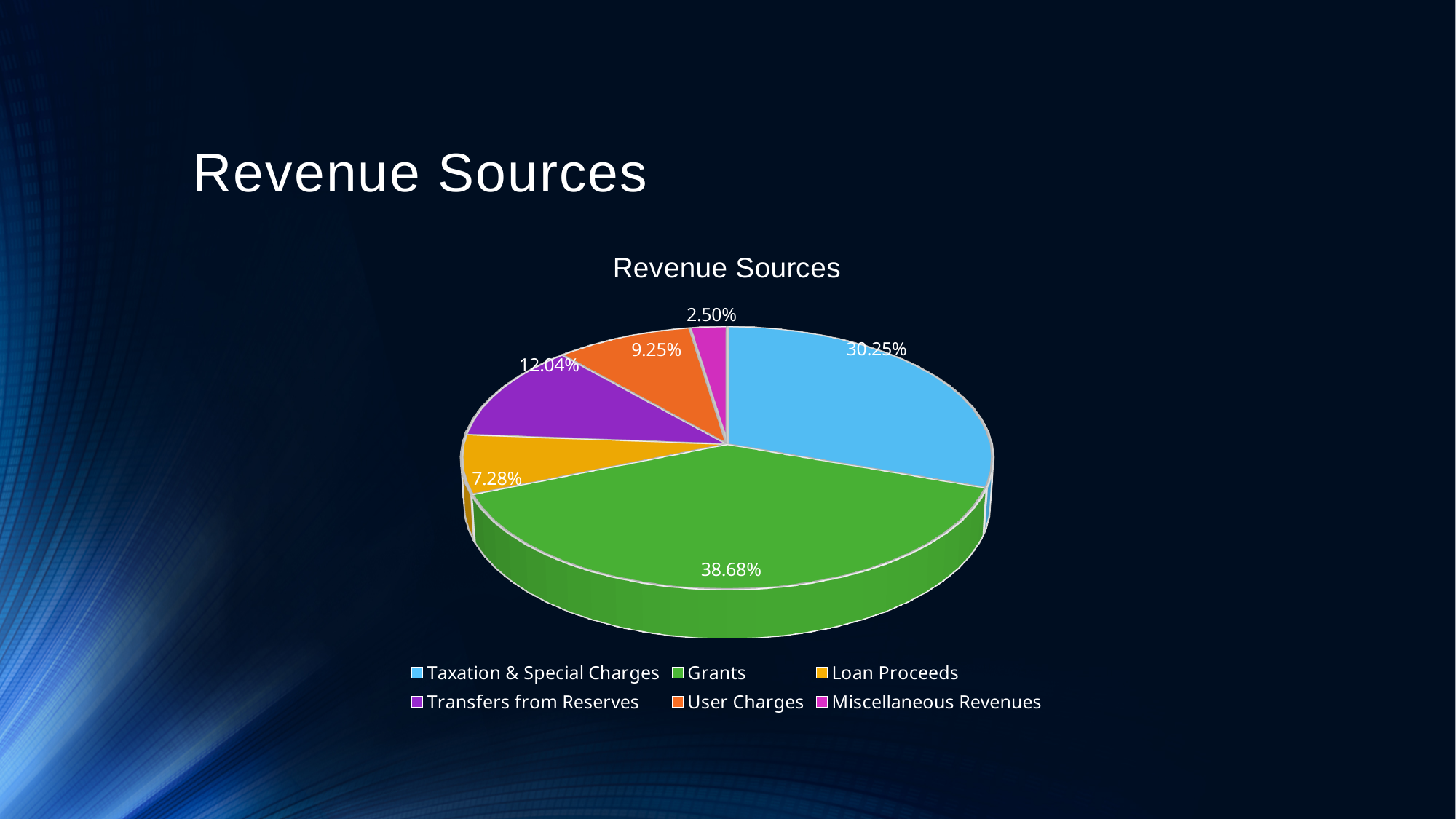
Which revenue source has the largest share? Grants Which revenue source has the smallest share? Miscellaneous Revenues What is the difference between the shares of Grants and Taxation & Special Charges? 8.43% What kind of chart is shown on the slide? Pie chart What is the value shown for Transfers from Reserves? 12.04% Which is larger, Transfers from Reserves or User Charges? Transfers from Reserves What is the value shown for Loan Proceeds? 7.28% What share of the pie does Grants represent? 38.68% How many revenue sources are shown in the chart? 6 What is the value shown for Taxation & Special Charges? 30.25% What is the value shown for User Charges? 9.25% What is the title of the chart? Revenue Sources